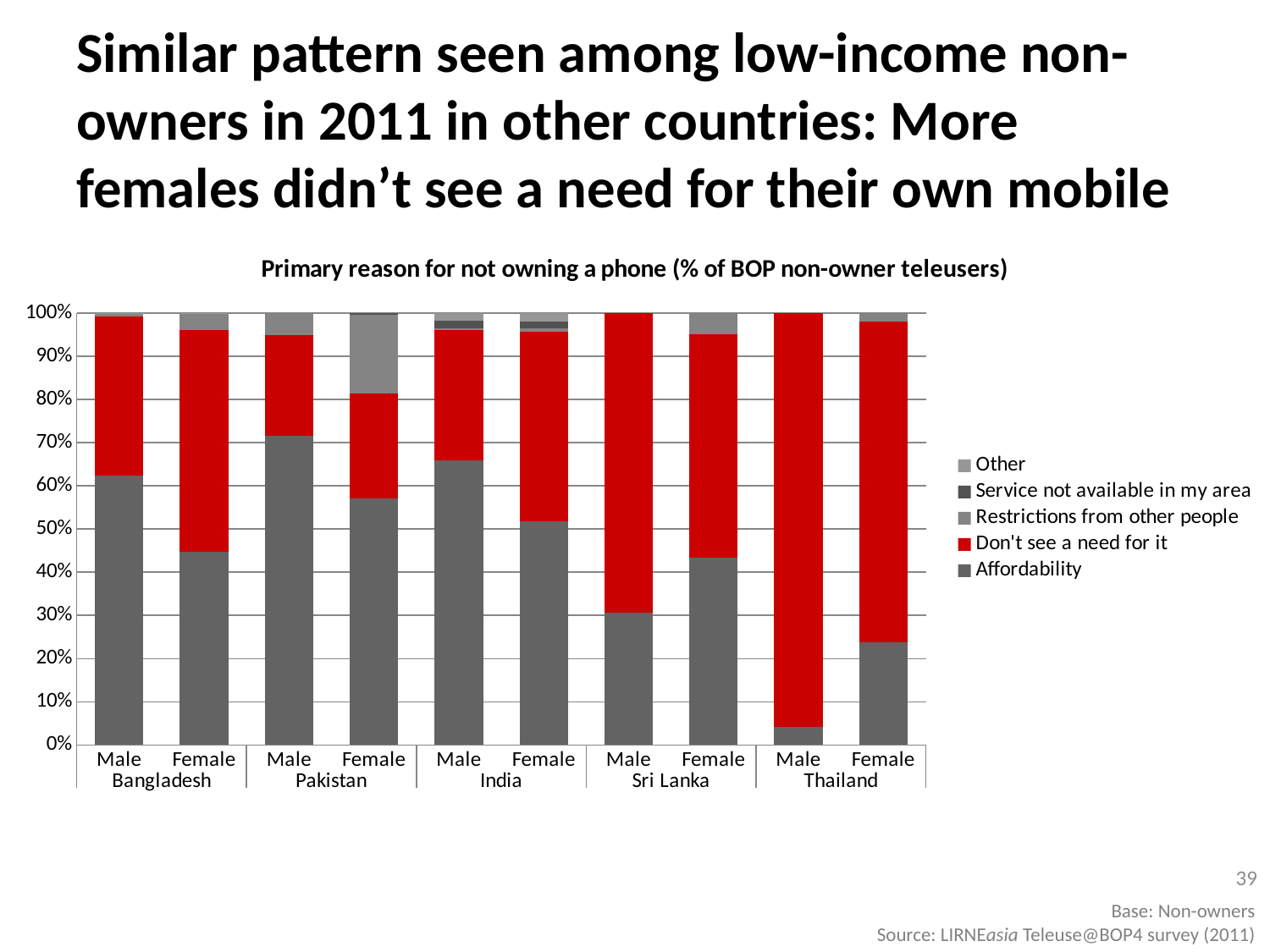
Which bar has the lowest Affordability share? Thailand Male What is the title of the chart? Primary reason for not owning a phone (% of BOP non-owner teleusers) Is the Affordability share for Thailand Male greater or less than 10%? less Which has the larger Affordability share, Sri Lanka Male or Sri Lanka Female? Sri Lanka Female Is the Affordability share for Bangladesh Male greater or less than 50%? greater Which colour represents 'Don't see a need for it' in the legend? Red Which bar has the highest Affordability share? Pakistan Male Which has the larger Affordability share, Bangladesh Male or Bangladesh Female? Bangladesh Male Is the Affordability share for Sri Lanka Male greater or less than 40%? less What kind of chart is shown on the slide? Stacked bar chart How many series does the legend list? 5 How many bars are plotted in the chart? 10